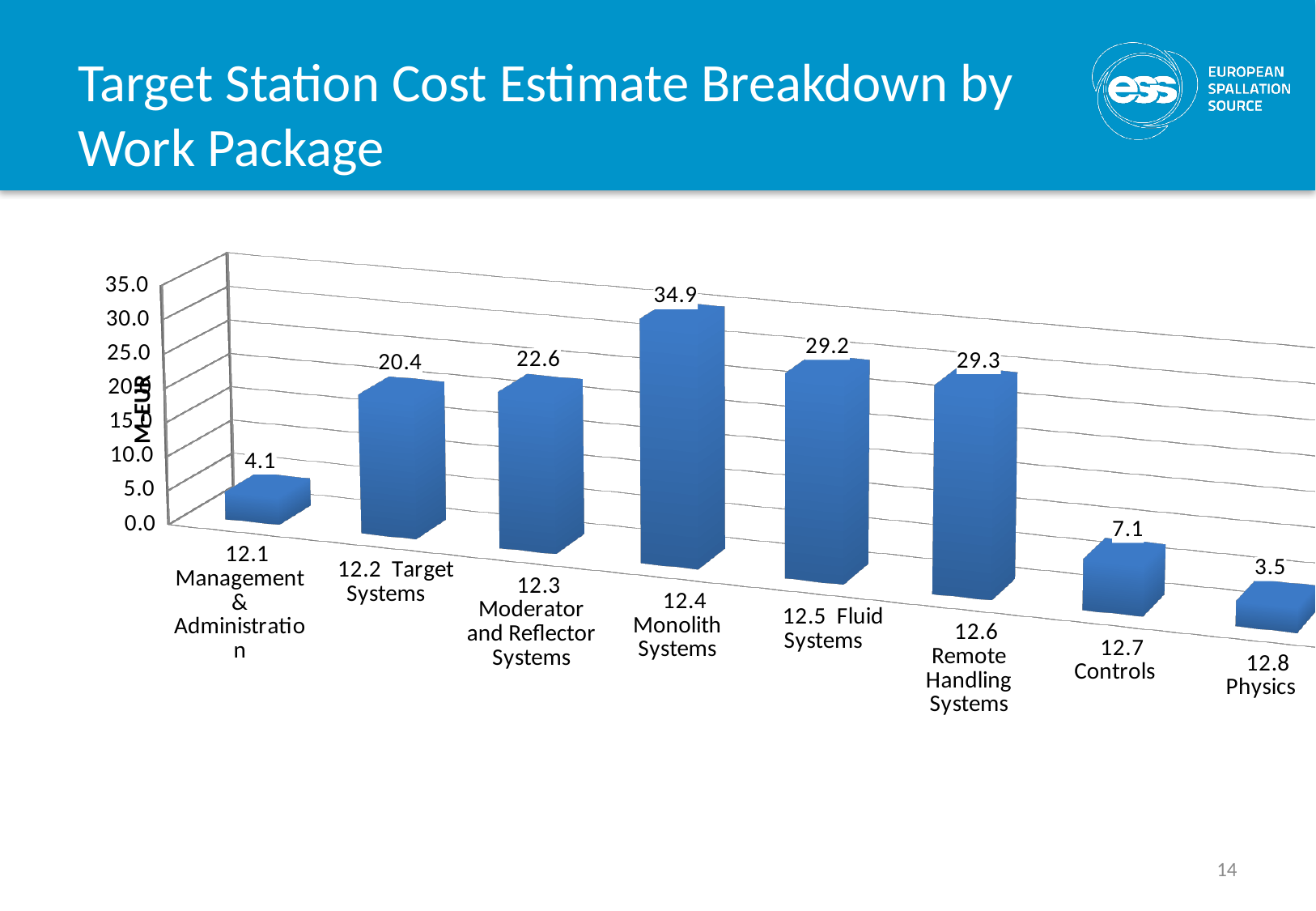
What is the value for 12.2 Target Systems? 20.4 What is the value for 12.4 Monolith Systems? 34.9 What is the value for 12.1 Management & Administration? 4.1 What is the label on the vertical axis of the chart? M-EUR What is the value for 12.7 Controls? 7.1 Which work package has the highest cost estimate? 12.4 Monolith Systems What kind of chart is shown on the slide? bar chart What is the difference between the values for 12.7 Controls and 12.8 Physics? 3.6 Which is larger, the value for 12.3 Moderator and Reflector Systems or 12.2 Target Systems? 12.3 Moderator and Reflector Systems What is the difference between the values for 12.4 Monolith Systems and 12.3 Moderator and Reflector Systems? 12.3 Which work package has the lowest cost estimate? 12.8 Physics How many work packages are shown in the chart? 8